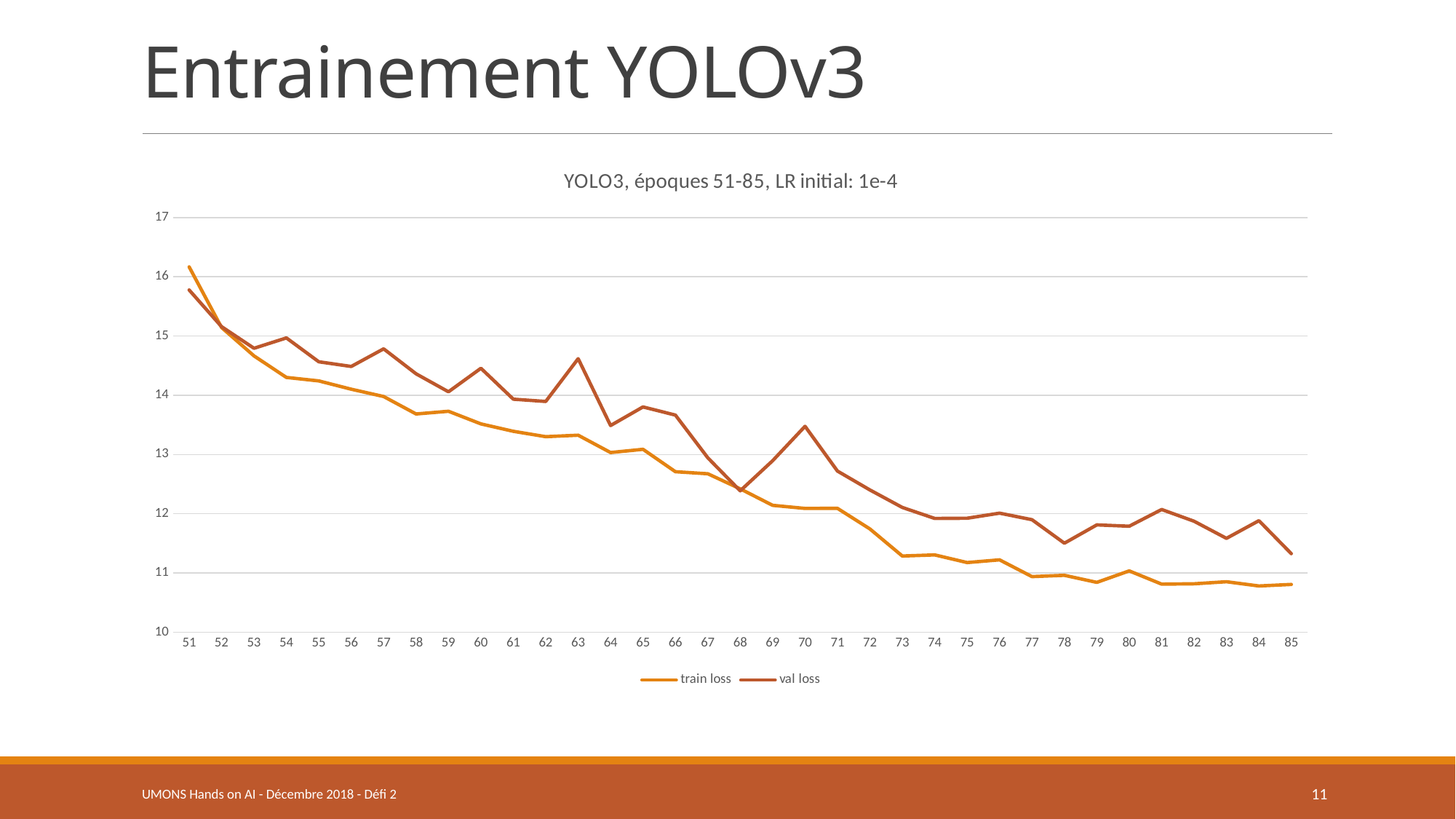
Which two series are listed in the chart legend? train loss and val loss At epoch 70, which is larger, the train loss or the val loss? val loss Is the train loss at epoch 85 greater or less than 11? less How many series does the legend list? 2 At which epoch is the val loss highest? 51 At which epoch is the train loss highest? 51 Is the train loss at epoch 54 greater or less than 14? greater Does the train loss rise or fall from epoch 51 to epoch 85? fall Is the val loss at epoch 70 greater or less than 13? greater How many epochs are plotted along the x axis? 35 What is the title of the chart? YOLO3, époques 51-85, LR initial: 1e-4 What kind of chart is shown on the slide? line chart